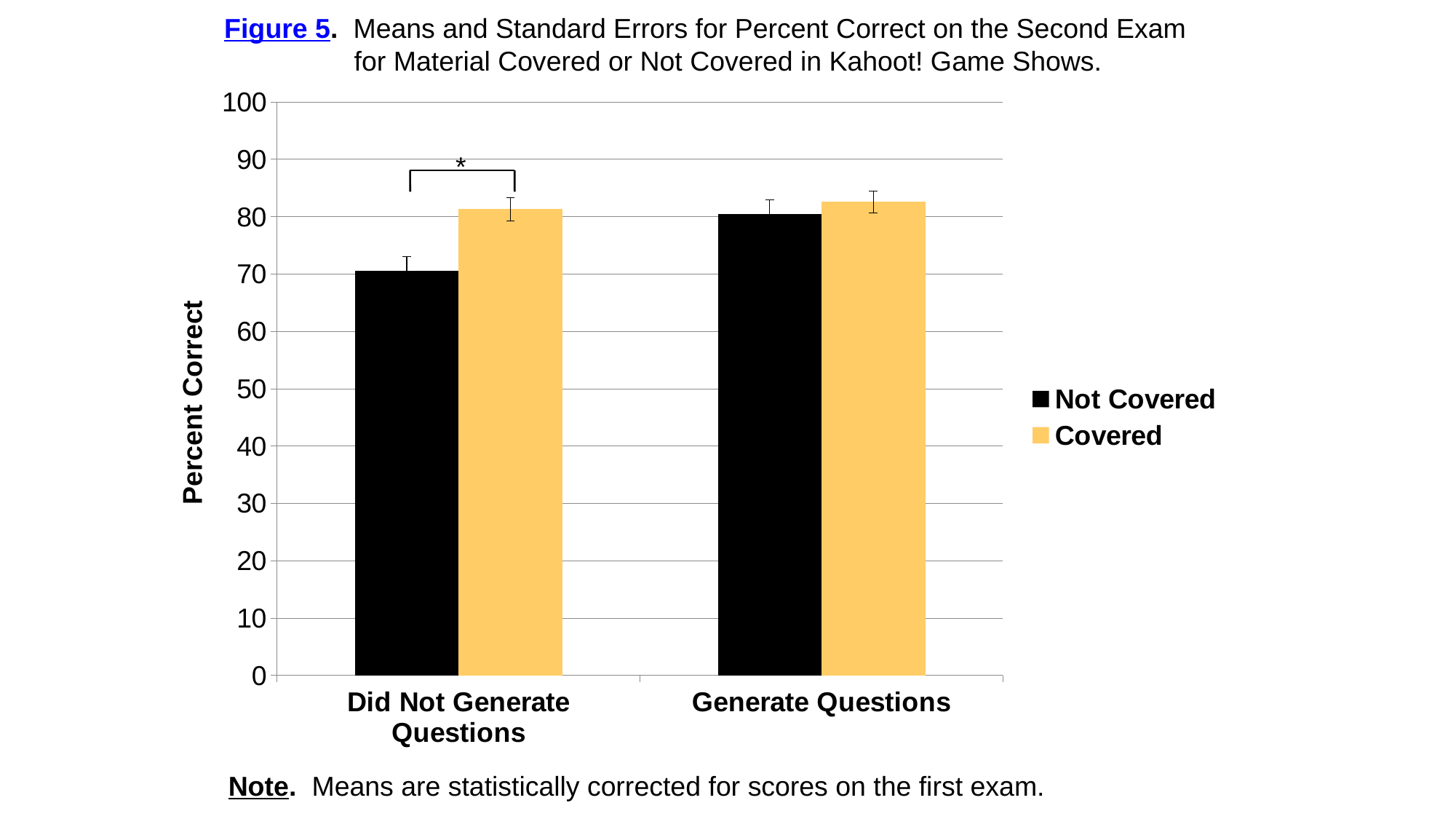
Is the Not Covered value for Generate Questions greater or less than 70? greater What kind of chart is shown on the slide? bar chart How many categories are shown on the x axis? 2 Is the Not Covered value for Did Not Generate Questions greater or less than 80? less Which series is shown in black? Not Covered Is the Covered value for Generate Questions greater or less than 90? less How many series does the legend list? 2 For Did Not Generate Questions, which is larger: the Not Covered value or the Covered value? Covered Which bar has the lowest value on the chart? Not Covered for Did Not Generate Questions What is the label of the y axis? Percent Correct